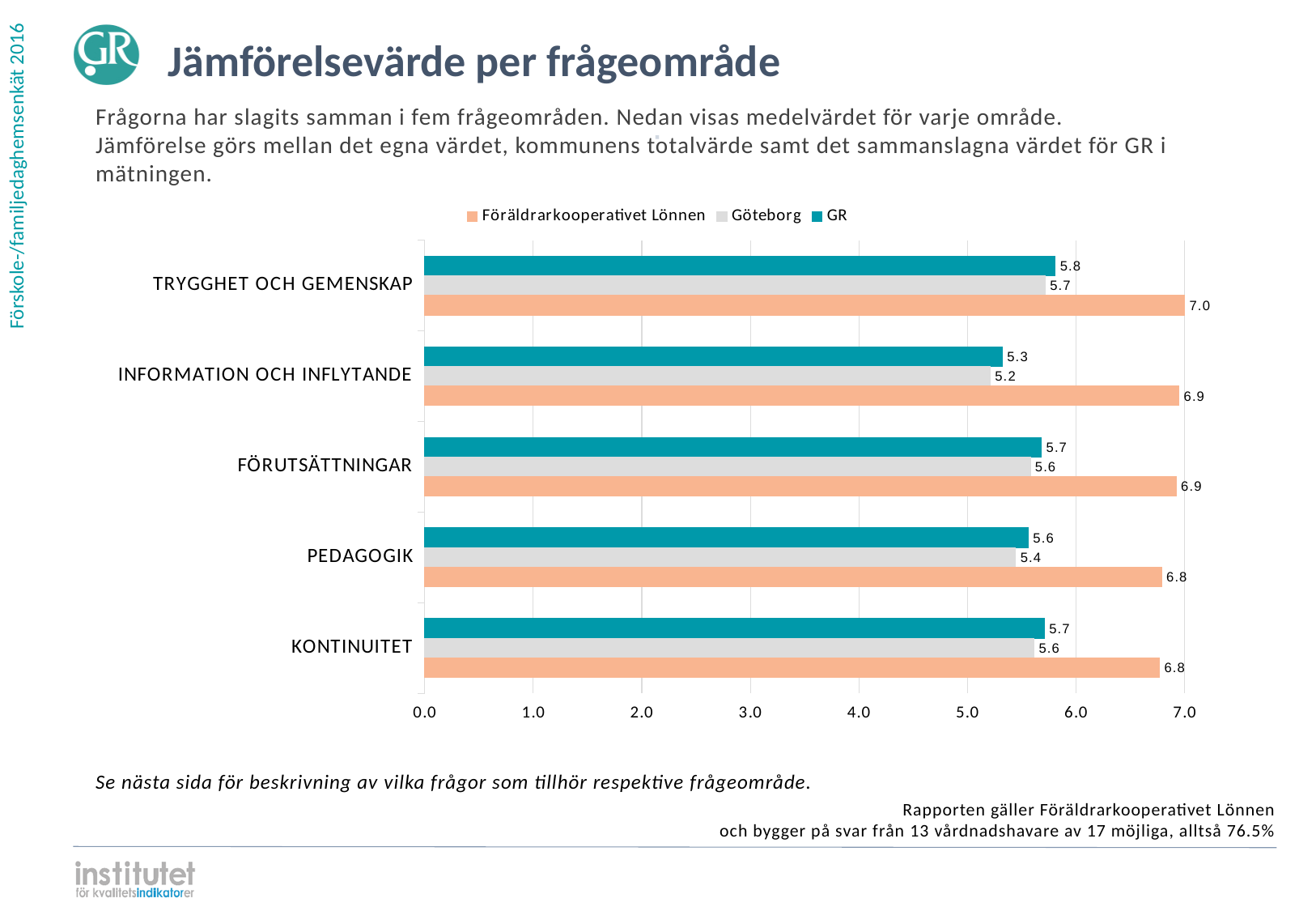
What is the difference between the GR value and the Göteborg value for PEDAGOGIK? 0.2 What is the GR value for PEDAGOGIK? 5.6 What kind of chart is shown on the slide? Bar chart Which category has the lowest GR value? INFORMATION OCH INFLYTANDE What is the Göteborg value for INFORMATION OCH INFLYTANDE? 5.2 What is the difference between the Föräldrarkooperativet Lönnen value and the Göteborg value for INFORMATION OCH INFLYTANDE? 1.7 How many series does the legend list? 3 Which series is shown in orange in the legend? Föräldrarkooperativet Lönnen How many categories (frågeområden) are shown on the chart? 5 What is the value for Föräldrarkooperativet Lönnen in the TRYGGHET OCH GEMENSKAP category? 7.0 For KONTINUITET, which is larger: the Föräldrarkooperativet Lönnen value or the GR value? Föräldrarkooperativet Lönnen Which category has the highest value for Föräldrarkooperativet Lönnen? TRYGGHET OCH GEMENSKAP